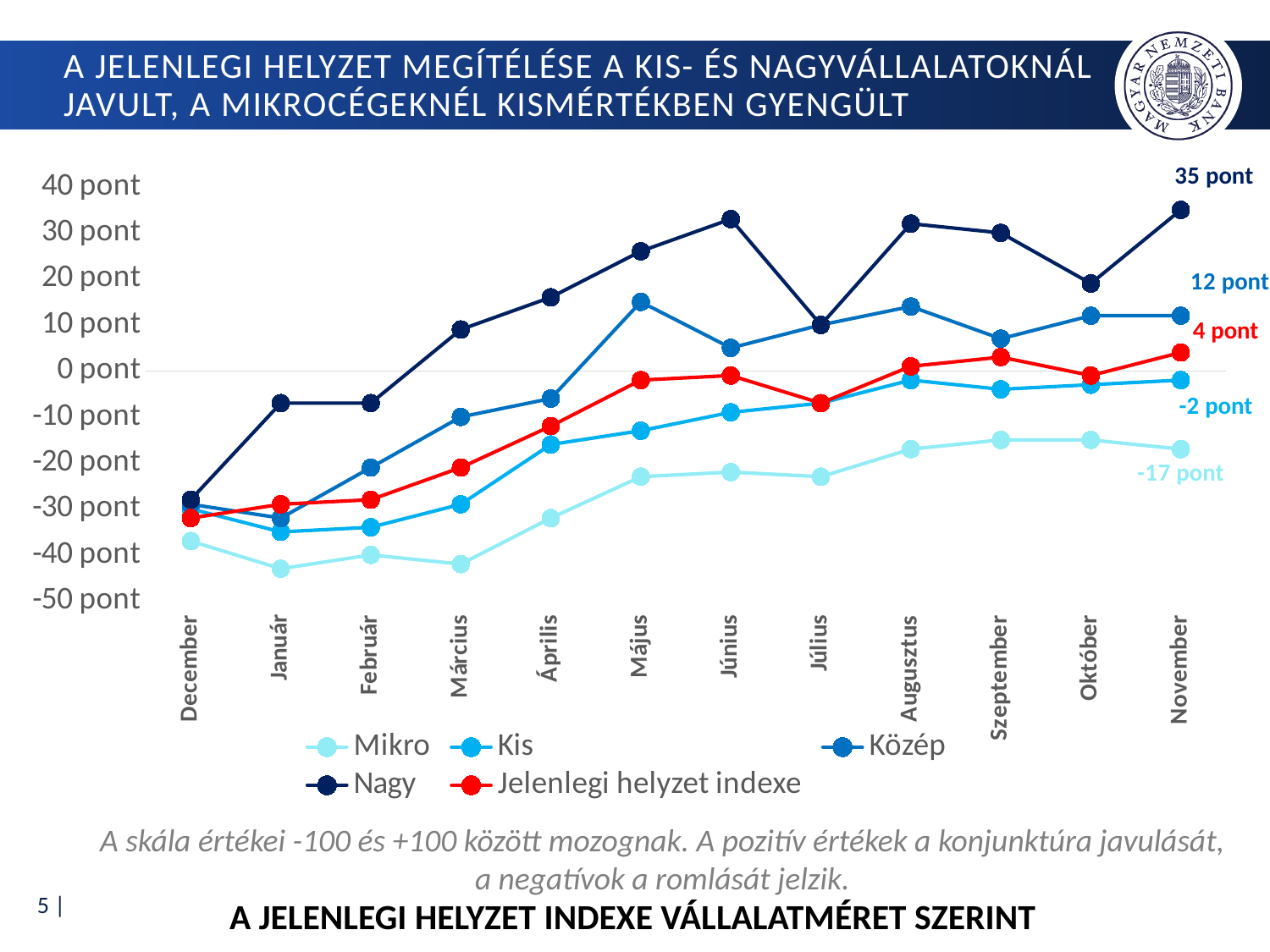
What is the value of the Nagy series in November? 35 pont In November, which is larger: the Kis value or the Jelenlegi helyzet indexe value? Jelenlegi helyzet indexe What is the value of the Jelenlegi helyzet indexe series in November? 4 pont Which series has the lowest value in November? Mikro Is the value for Nagy in Június greater or less than 30 pont? greater Which series has the highest value in November? Nagy What is the difference between the Nagy and Közép values in November? 23 pont How many months are shown on the x axis? 12 What is the value of the Közép series in November? 12 pont What is the value of the Mikro series in November? -17 pont How many series does the legend list? 5 What kind of chart is shown on the slide? line chart